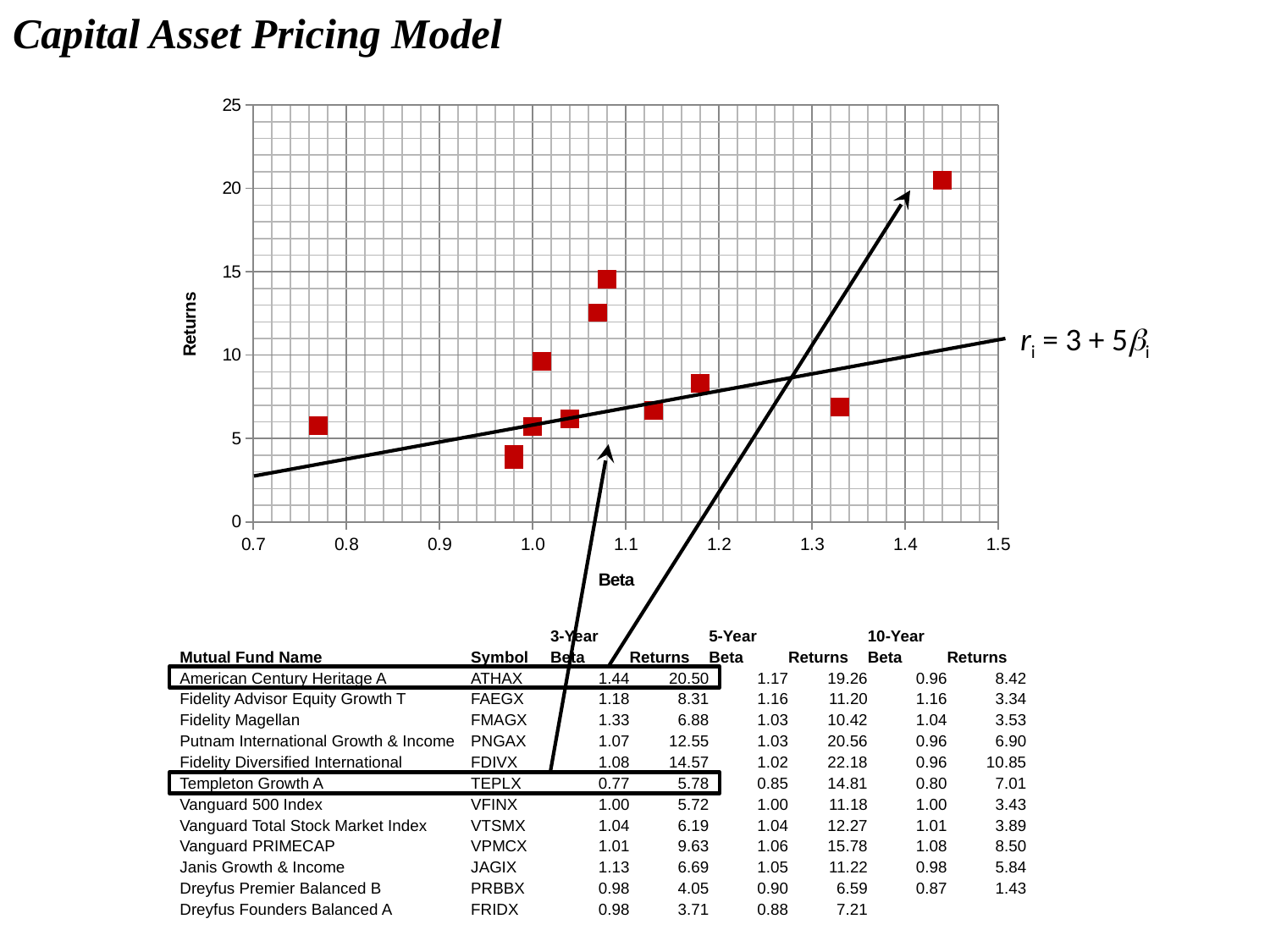
What is the label of the x axis of the chart? Beta Which fund has the lowest beta plotted on the chart? Templeton Growth A (TEPLX) Is the return for the point at beta 1.33 greater or less than 10? less What is the 3-year beta of Templeton Growth A (TEPLX), the leftmost point on the chart? 0.77 What is the 3-year return of Templeton Growth A (TEPLX)? 5.78 Which has the higher 3-year return, Putnam International Growth & Income (beta 1.07) or Fidelity Diversified International (beta 1.08)? Fidelity Diversified International Is the return for the point at beta 1.44 greater or less than 15? greater What is the difference between the 3-year returns of American Century Heritage A (20.50) and Templeton Growth A (5.78)? 14.72 What equation is written next to the line drawn through the scatter chart? r_i = 3 + 5β_i What is the 3-year return of American Century Heritage A (ATHAX), the highest point on the chart? 20.50 Which mutual fund has the highest 3-year return plotted on the chart? American Century Heritage A (ATHAX) What kind of chart is shown on the slide? scatter chart